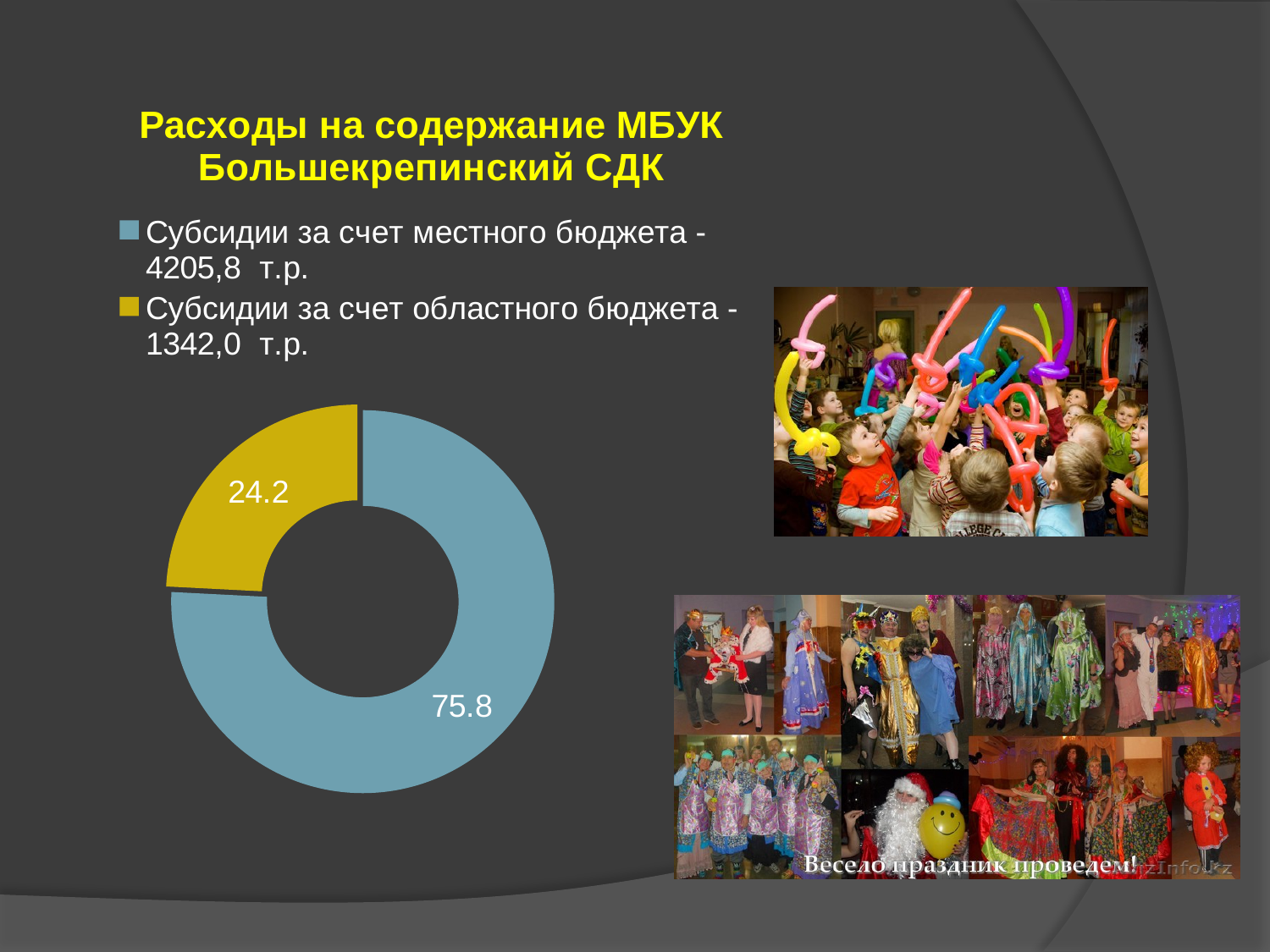
How many slices does the chart have? 2 What value is shown for the yellow slice (Субсидии за счет областного бюджета)? 24.2 Which category has the smallest slice of the chart? Субсидии за счет областного бюджета What amount in т.р. is given in the legend for Субсидии за счет местного бюджета? 4205,8 т.р. How many entries does the legend list? 2 What colour is the slice for Субсидии за счет областного бюджета? Yellow What is the total of the two slice values shown on the chart? 100 Which is larger: the slice for местного бюджета or the slice for областного бюджета? местного бюджета What kind of chart is shown on the slide? Doughnut (pie) chart What is the difference between the two slice values, 75.8 and 24.2? 51.6 What value is shown for the blue slice (Субсидии за счет местного бюджета)? 75.8 Which category has the largest slice of the chart? Субсидии за счет местного бюджета